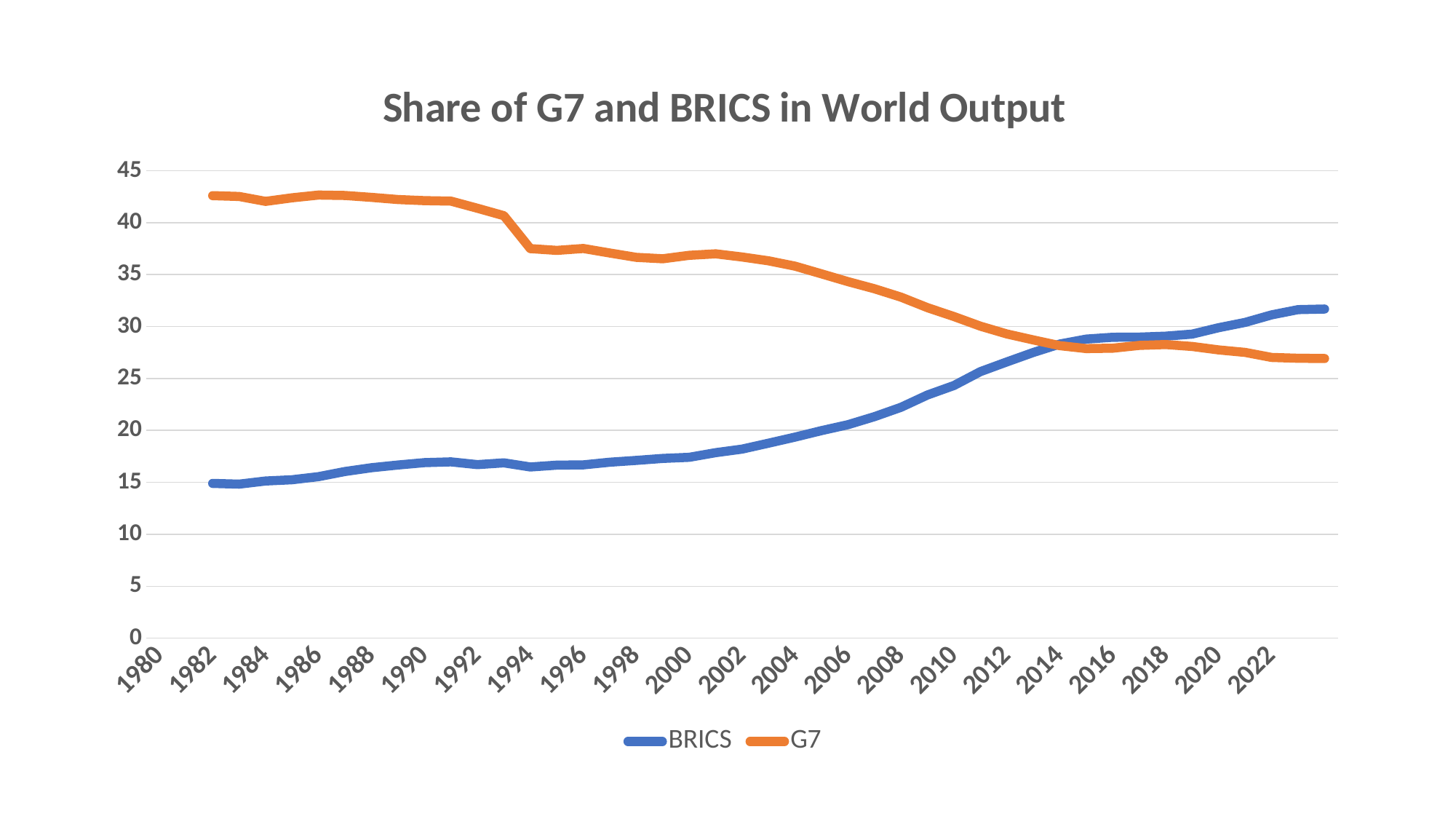
How many series does the legend list? 2 Is the value for BRICS in 2022 greater or less than 30? greater Is the value for BRICS in 1982 greater or less than 20? less What is the title of the chart? Share of G7 and BRICS in World Output Does the BRICS line rise or fall from 1982 to 2022? rise Does the G7 line rise or fall from 1982 to 2022? fall In 2022, which series has the larger value, BRICS or G7? BRICS Is the value for G7 in 1982 greater or less than 40? greater Which colour is used for the BRICS line? blue What kind of chart is shown on the slide? line chart In 2000, which series has the larger value, BRICS or G7? G7